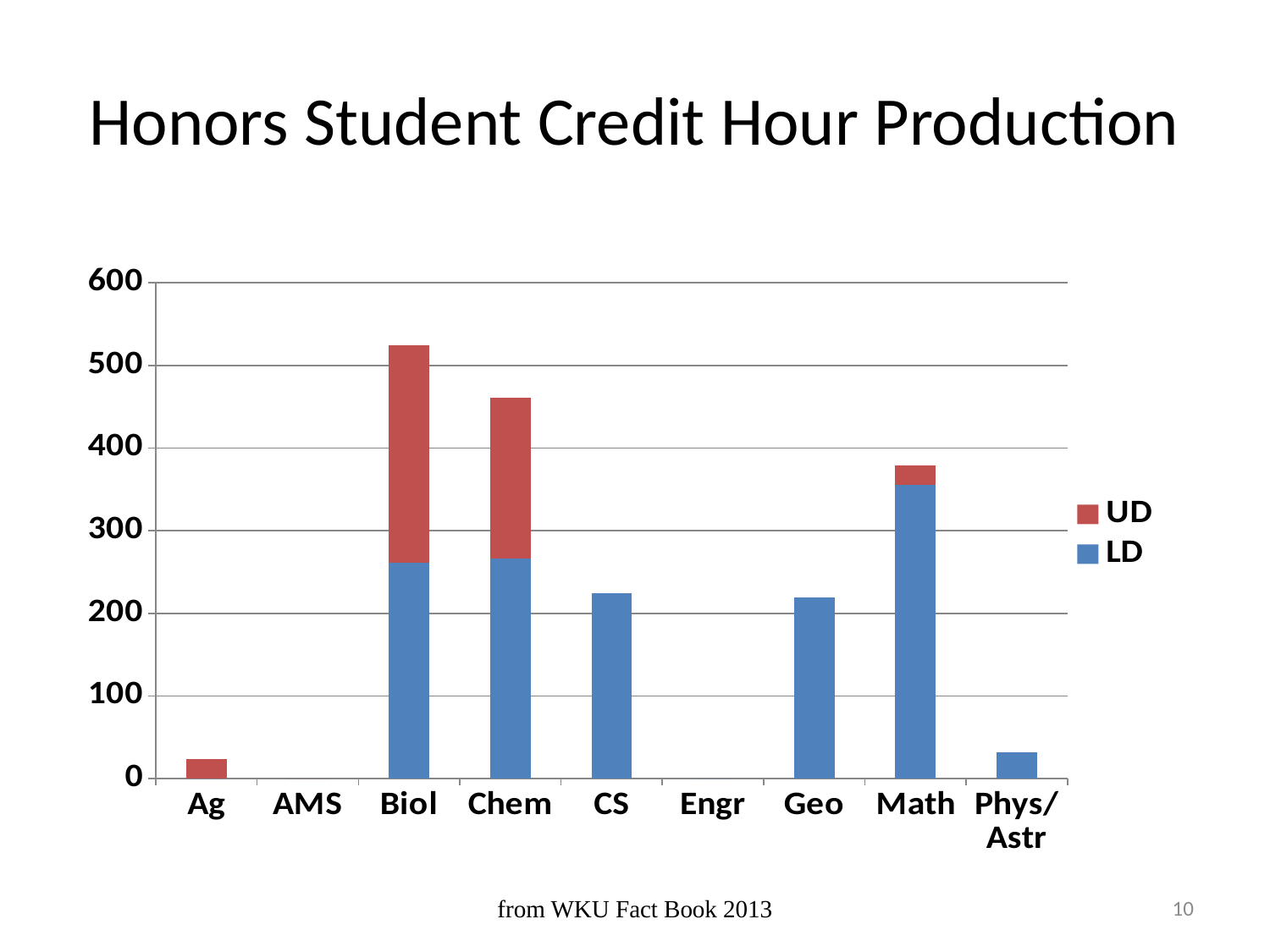
Which has a larger total, Biol or Chem? Biol How many series does the legend list? 2 Which category has the highest total credit hour production? Biol What type of chart is shown on the slide? Stacked bar chart Which has a larger LD value, Math or Biol? Math Is the value for Phys/Astr greater or less than 100? less Is the total value for Math greater or less than 400? less What is the title of the chart? Honors Student Credit Hour Production Is the total value for Chem greater or less than 400? greater Which colour represents the UD series in the legend? Red How many categories are shown on the x axis? 9